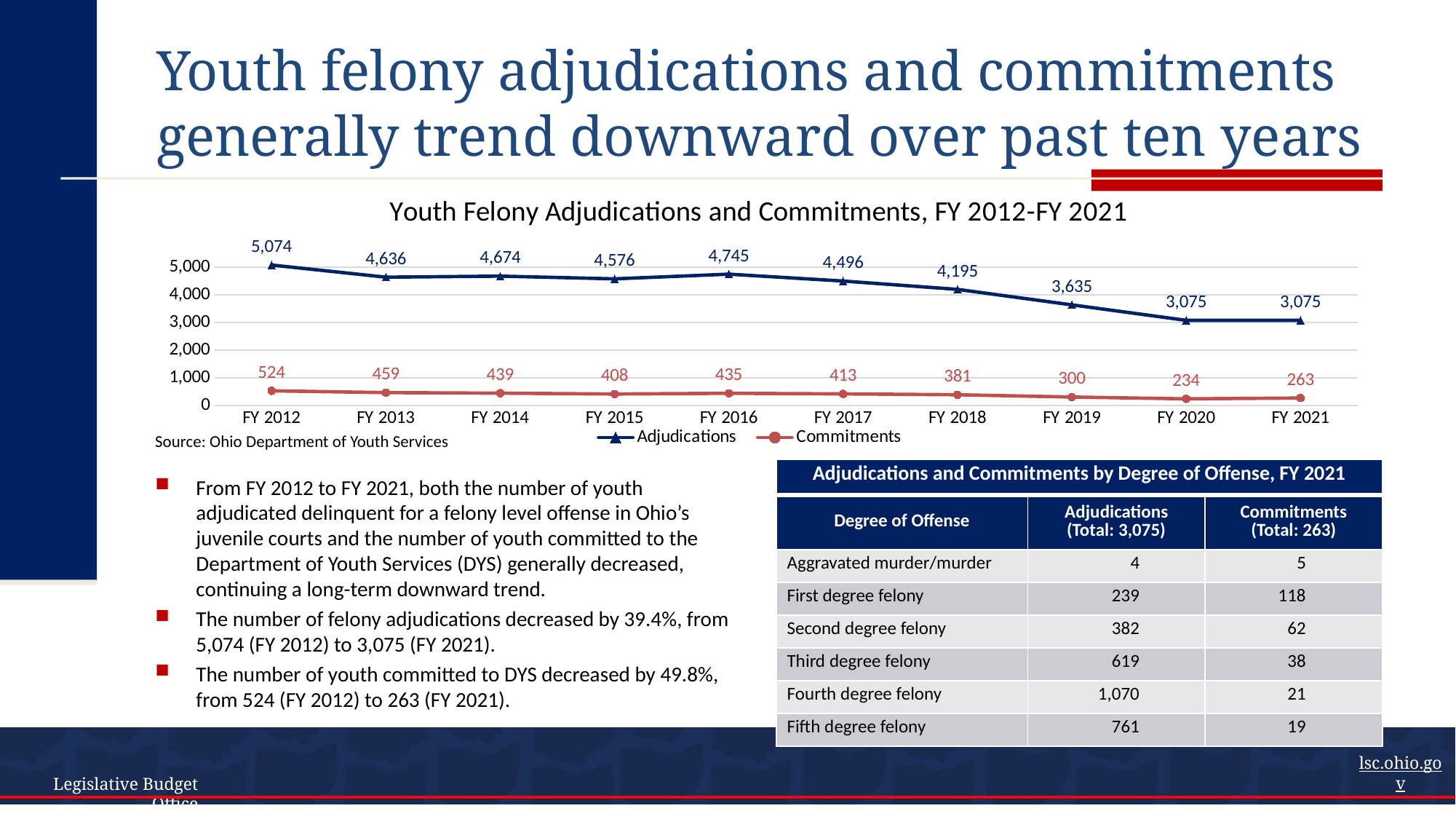
In which fiscal year is the Adjudications series highest? FY 2012 In which fiscal year is the Commitments series lowest? FY 2020 What is the value for Adjudications in FY 2016? 4,745 What is the difference between Adjudications in FY 2012 and FY 2021? 1,999 What is the value for Commitments in FY 2020? 234 Which is larger, Adjudications in FY 2018 or Adjudications in FY 2019? FY 2018 What is the value for Adjudications in FY 2012? 5,074 How many fiscal years are plotted on the x axis? 10 What is the difference between Commitments in FY 2012 and FY 2021? 261 Do the Adjudications values generally rise or fall from FY 2012 to FY 2021? Fall What kind of chart is shown? Line chart How many series does the legend list? 2